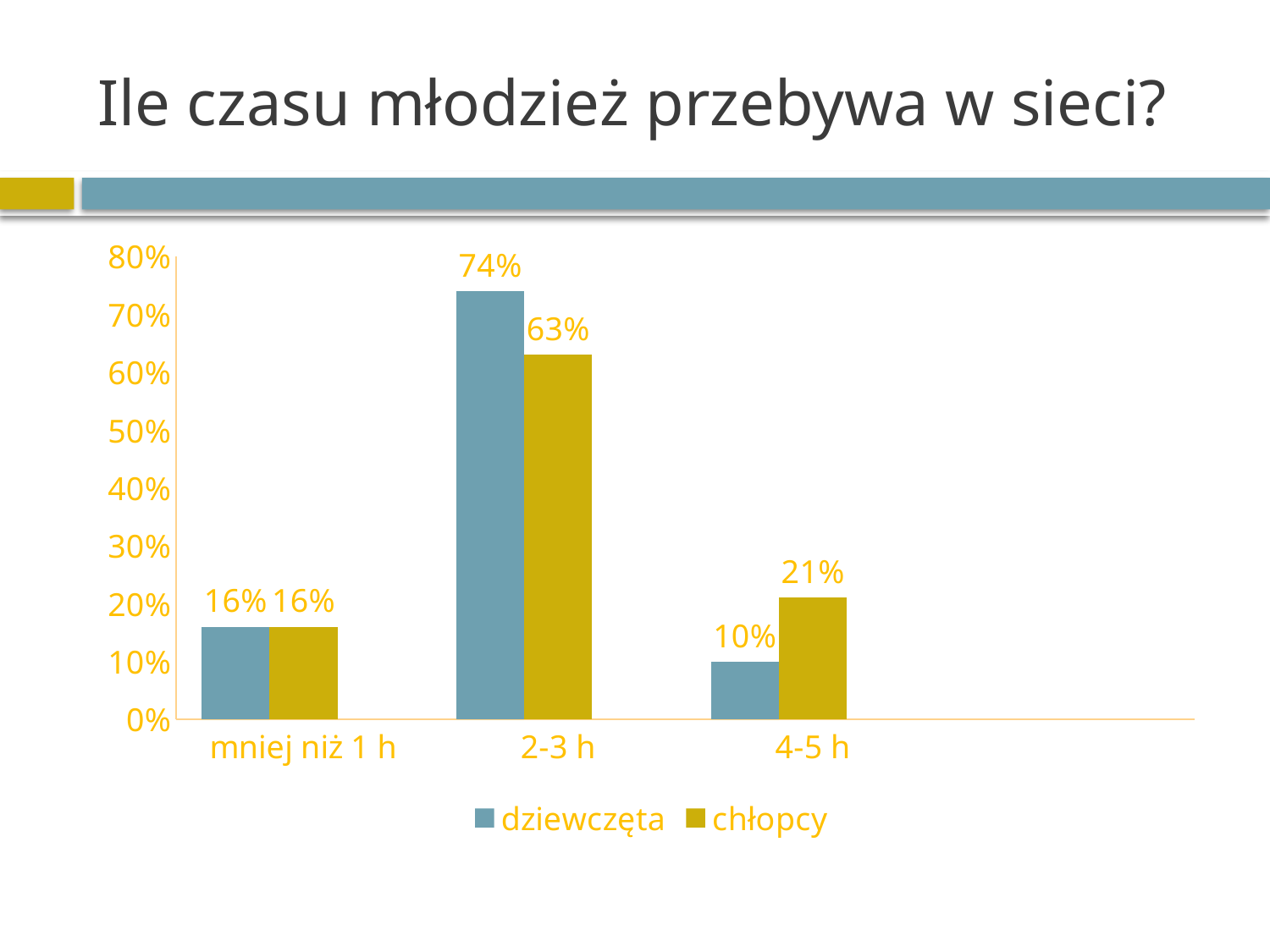
Which category has the highest value for chłopcy? 2-3 h Which category has the lowest value for dziewczęta? 4-5 h What is the title of the slide? Ile czasu młodzież przebywa w sieci? What is the value for dziewczęta in the 4-5 h category? 10% What is the difference between dziewczęta and chłopcy in the 2-3 h category? 11% What is the value for chłopcy in the 'mniej niż 1 h' category? 16% What is the value for chłopcy in the 4-5 h category? 21% What is the value for dziewczęta in the 2-3 h category? 74% How many series does the legend list? 2 In the 4-5 h category, which series has the larger value, dziewczęta or chłopcy? chłopcy What kind of chart is shown on the slide? bar chart How many categories are shown on the x axis? 3